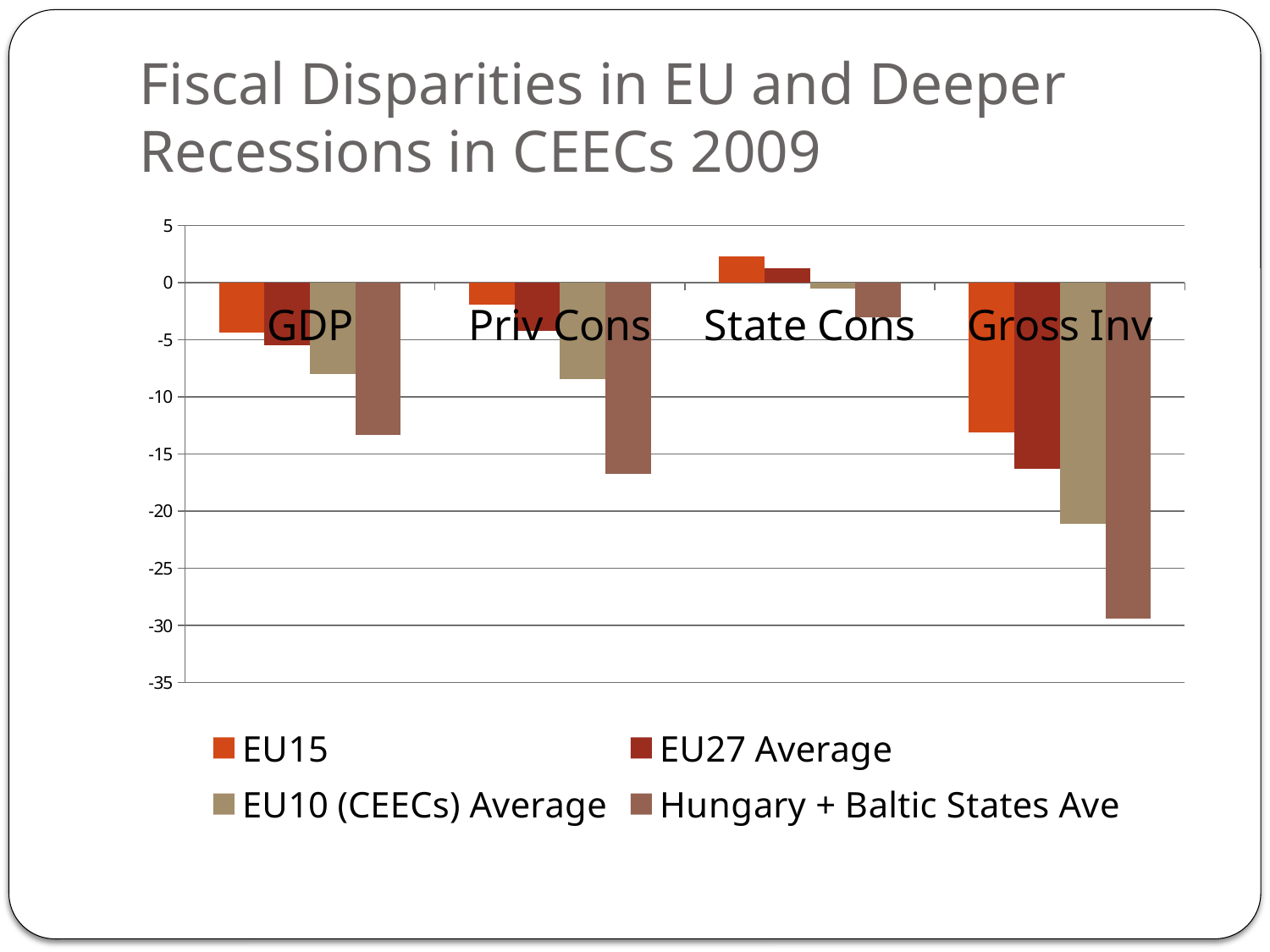
Which is larger in the State Cons category, the EU15 value or the EU27 Average value? EU15 Is the value for EU15 in the GDP category greater or less than -5? greater Which series is shown in the darkest red colour in the legend? EU27 Average Is the value for EU10 (CEECs) Average in the Gross Inv category greater or less than -20? less Is the value for Hungary + Baltic States Ave in the Gross Inv category greater or less than -25? less Which category has the highest value for the EU15 series? State Cons How many categories are shown on the x axis of the chart? 4 What kind of chart is shown on the slide? bar chart Which is larger, the EU15 value for Priv Cons or the EU15 value for Gross Inv? Priv Cons How many series does the chart's legend list? 4 Which series has the lowest value in the Gross Inv category? Hungary + Baltic States Ave Which category has the lowest value for the Hungary + Baltic States Ave series? Gross Inv